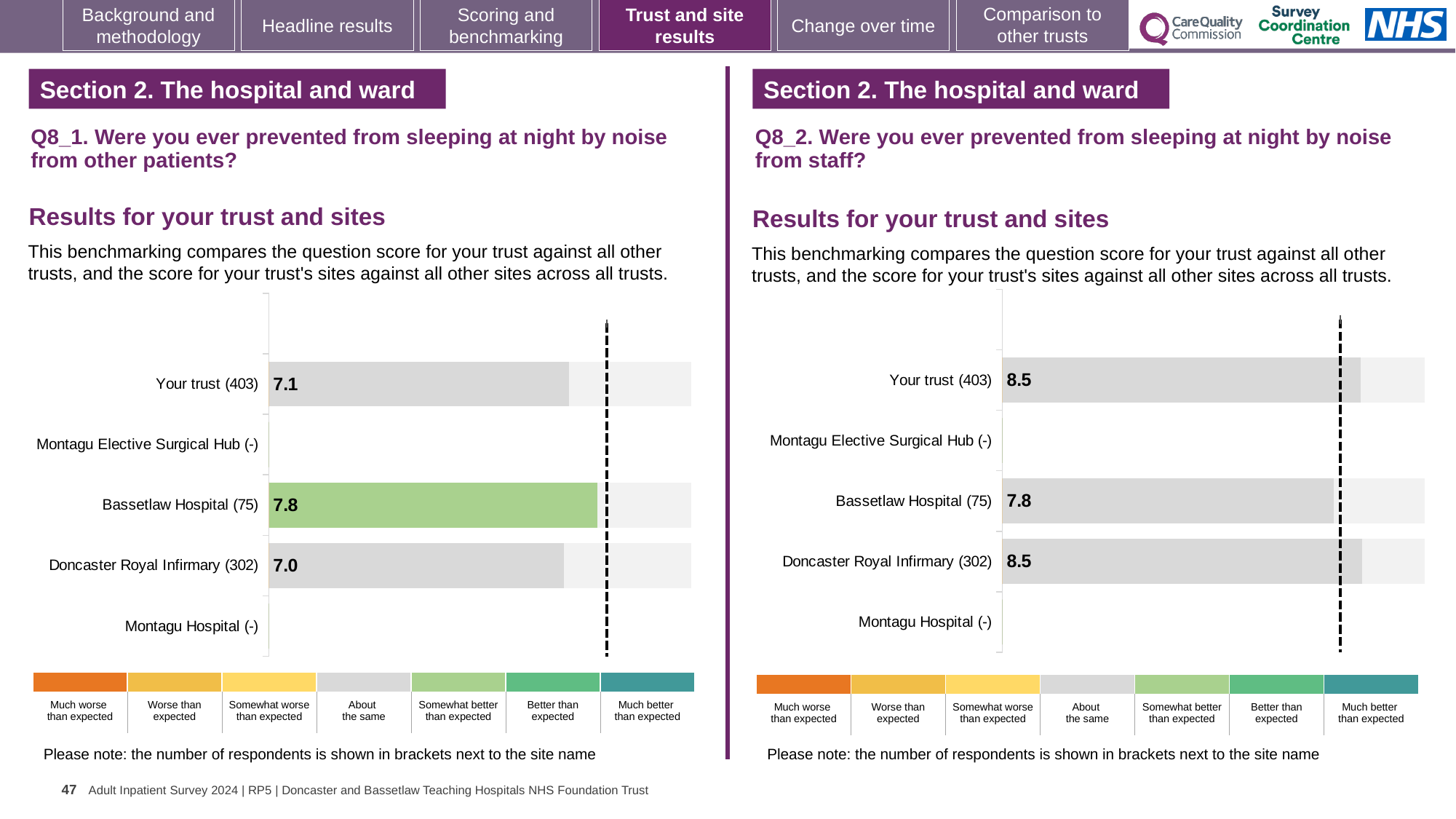
On the Q8_2 chart (right), which of Your trust (403) or Bassetlaw Hospital (75) has the higher score? Your trust (403) What kind of chart is the Q8_2 chart (right)? Bar chart On the Q8_2 chart (right), what is the score for Your trust (403)? 8.5 On the Q8_1 chart (left), which site's bar is coloured green? Bassetlaw Hospital (75) On the Q8_1 chart (left), what is the score for Doncaster Royal Infirmary (302)? 7.0 On the Q8_1 chart (left), which site has the highest score? Bassetlaw Hospital (75) On the Q8_1 chart (left), what is the score for Bassetlaw Hospital (75)? 7.8 On the Q8_1 chart (left), how many site rows are listed on the vertical axis? 5 On the Q8_2 chart (right), what is the score for Bassetlaw Hospital (75)? 7.8 On the Q8_2 chart (right), what is the difference between the scores for Doncaster Royal Infirmary (302) and Bassetlaw Hospital (75)? 0.7 On the Q8_1 chart (left), what is the score for Your trust (403)? 7.1 On the Q8_1 chart (left), what is the difference between the scores for Bassetlaw Hospital (75) and Doncaster Royal Infirmary (302)? 0.8